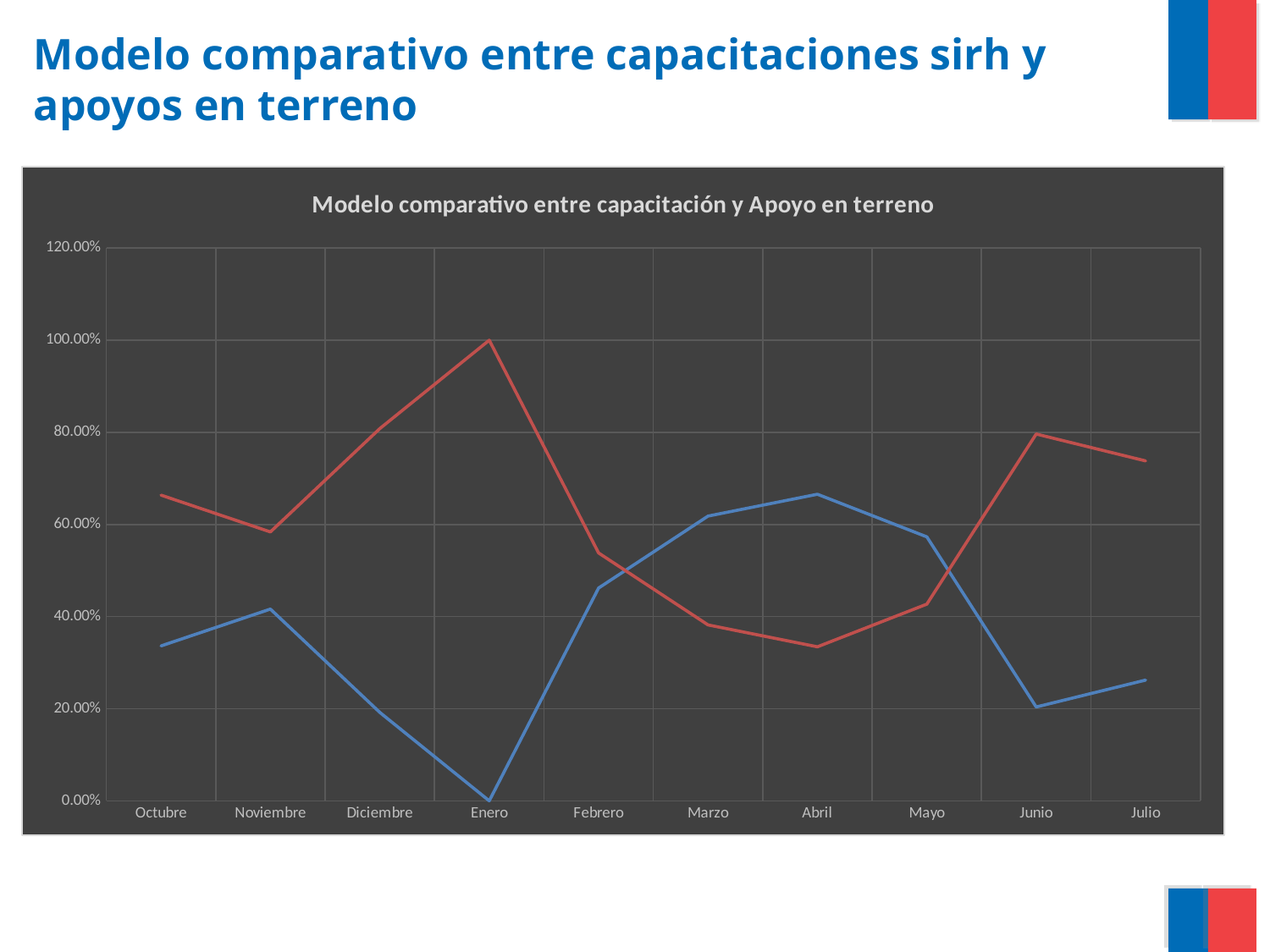
In which month does the red line reach its highest value? Enero What kind of chart is shown on the slide? Line chart Is the value of the red line in Octubre greater or less than 60.00%? greater What is the value of the red line in Enero? 100.00% How many months are shown along the x axis of the chart? 10 In which month does the blue line reach its highest value? Abril In which month does the blue line reach its lowest value? Enero Is the value of the red line in Abril greater or less than 40.00%? less What is the title of the chart? Modelo comparativo entre capacitación y Apoyo en terreno How many lines are plotted on the chart? 2 What is the value of the blue line in Enero? 0.00% In Abril, which line has the higher value, the red line or the blue line? The blue line